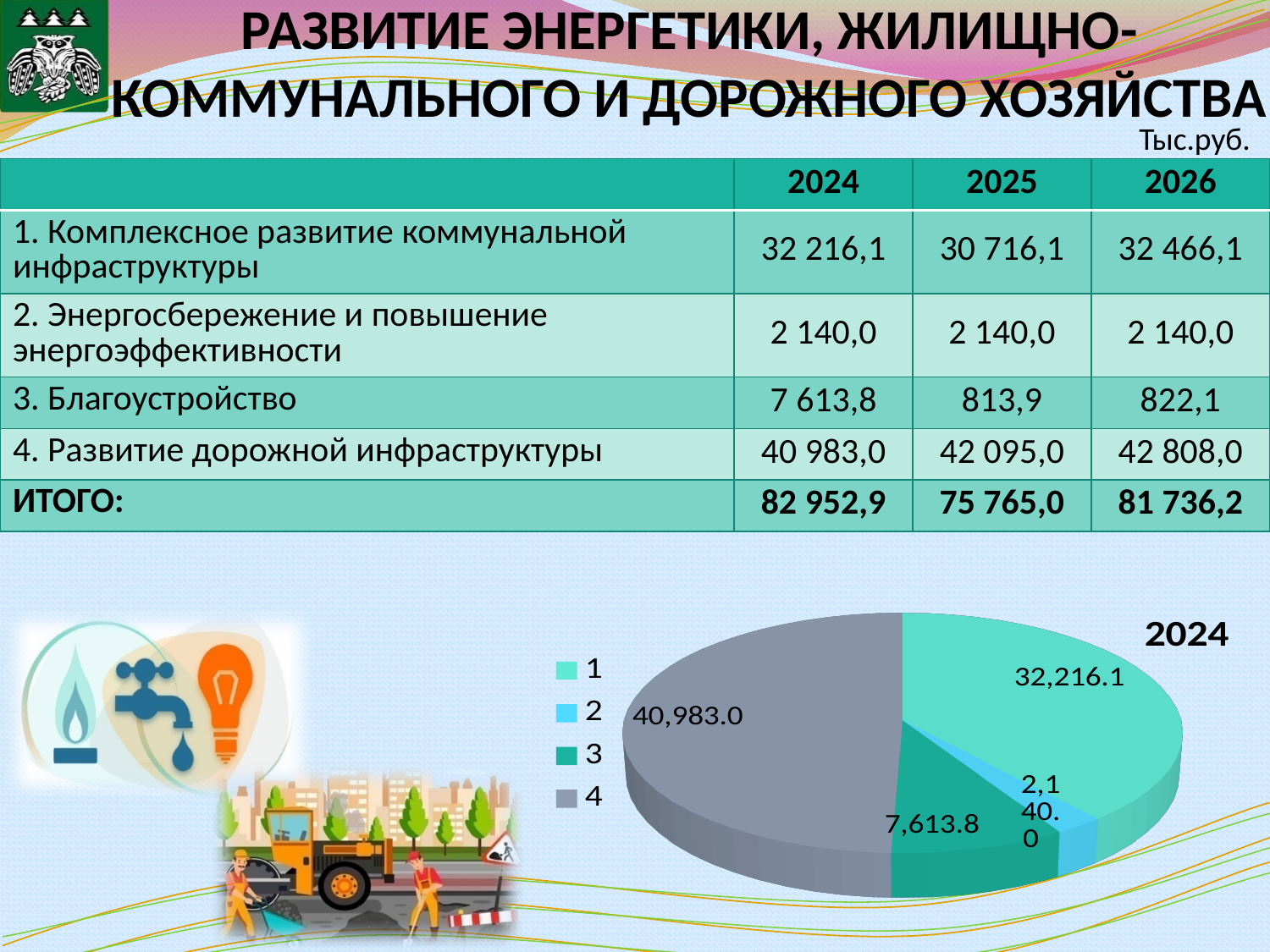
What value is shown for slice 1 in the pie chart? 32,216.1 Which slice of the pie chart is the largest? 4 What value is shown for slice 3 in the pie chart? 7,613.8 Which slice of the pie chart is the smallest? 2 What is the difference between the values of slice 4 and slice 1 in the pie chart? 8,766.9 What colour is slice 4 in the pie chart? grey In the pie chart, which is larger: slice 1 or slice 3? slice 1 What is the title of the pie chart? 2024 How many entries does the legend of the pie chart list? 4 How many slices does the pie chart have? 4 What value is shown for slice 4 in the pie chart? 40,983.0 What kind of chart is shown on the slide? pie chart